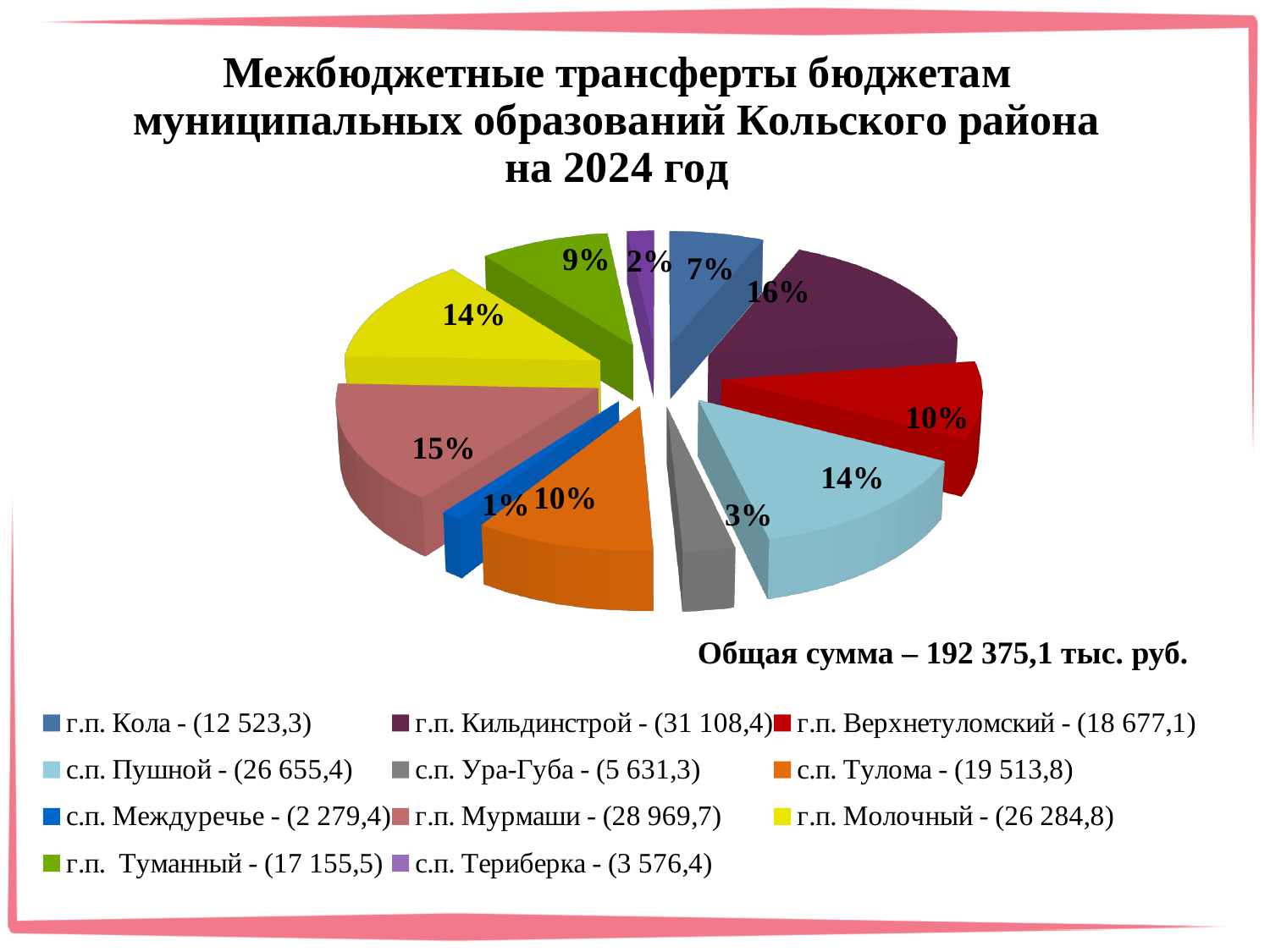
Which municipality has the largest share of the pie? г.п. Кильдинстрой What is the difference between the legend amounts for г.п. Кильдинстрой and г.п. Мурмаши? 2 138,7 What total sum is stated on the slide for all transfers? 192 375,1 тыс. руб. Which municipality has the smallest share of the pie? с.п. Междуречье What colour is the slice for г.п. Молочный? Yellow What kind of chart is shown on the slide? Pie chart Which is larger, the share for г.п. Мурмаши or the share for г.п. Туманный? г.п. Мурмаши What is the transfer amount shown in the legend for с.п. Териберка? 3 576,4 What is the transfer amount shown in the legend for г.п. Мурмаши? 28 969,7 What share of the pie does с.п. Ура-Губа account for? 3% What share of the pie does г.п. Кильдинстрой account for? 16% How many slices does the pie chart have? 11